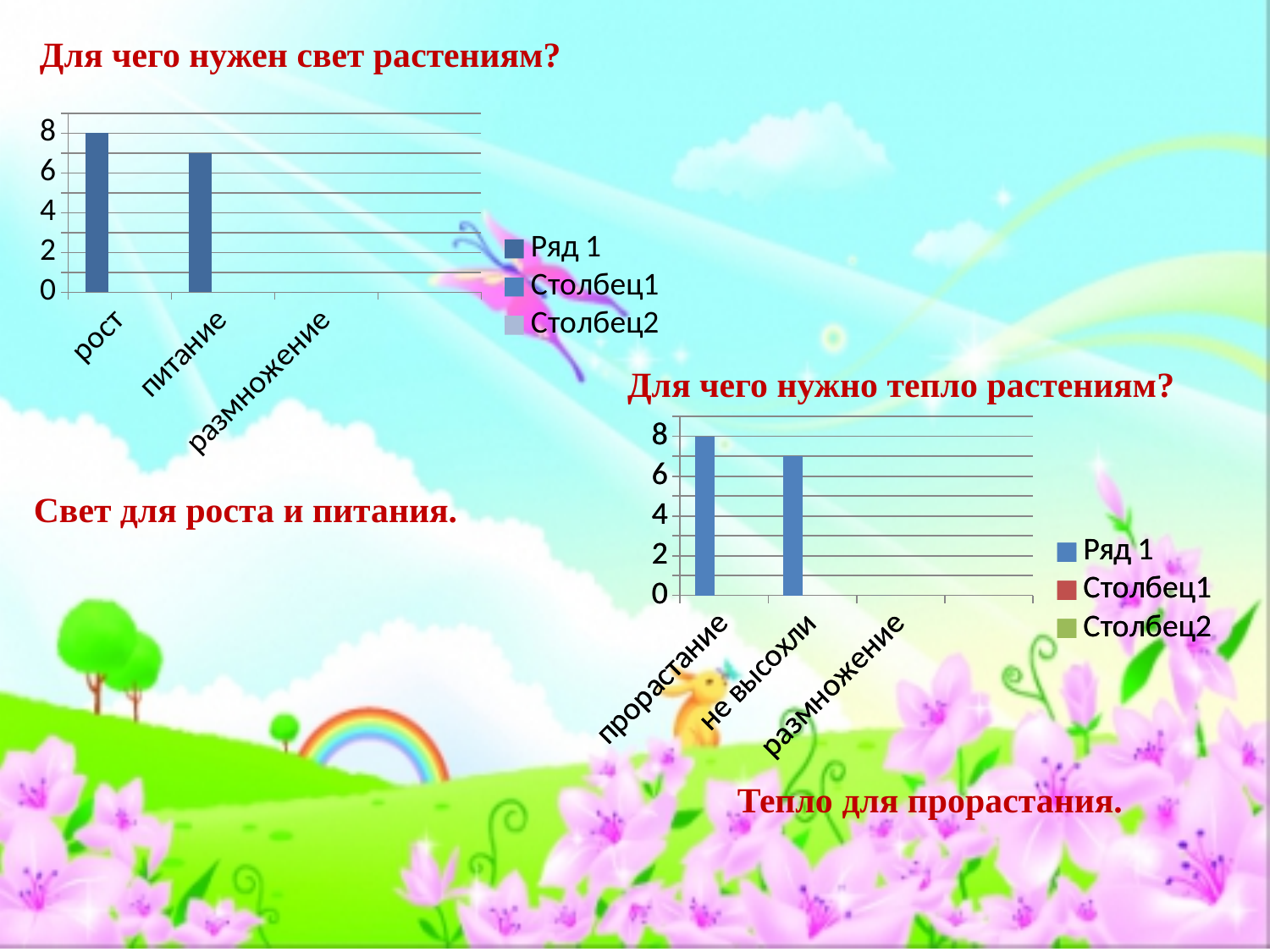
In the chart titled "Для чего нужно тепло растениям?", is the value for не высохли greater or less than 6? greater In the chart titled "Для чего нужно тепло растениям?", which category has the lowest bar? размножение In the chart titled "Для чего нужен свет растениям?", how many categories are shown on the x axis? 3 In the chart titled "Для чего нужен свет растениям?", what is the value for рост? 8 In the chart titled "Для чего нужно тепло растениям?", do the values rise or fall from left to right along the x axis? fall In the chart titled "Для чего нужен свет растениям?", how many entries does the legend list? 3 In the chart titled "Для чего нужно тепло растениям?", what is the first entry in the legend? Ряд 1 In the chart titled "Для чего нужен свет растениям?", which category has the highest bar? рост What kind of chart is the one titled "Для чего нужен свет растениям?"? bar chart In the chart titled "Для чего нужен свет растениям?", is the value for питание greater or less than 6? greater In the chart titled "Для чего нужно тепло растениям?", what is the value for прорастание? 8 In the chart titled "Для чего нужно тепло растениям?", which is larger, the value for прорастание or the value for не высохли? прорастание